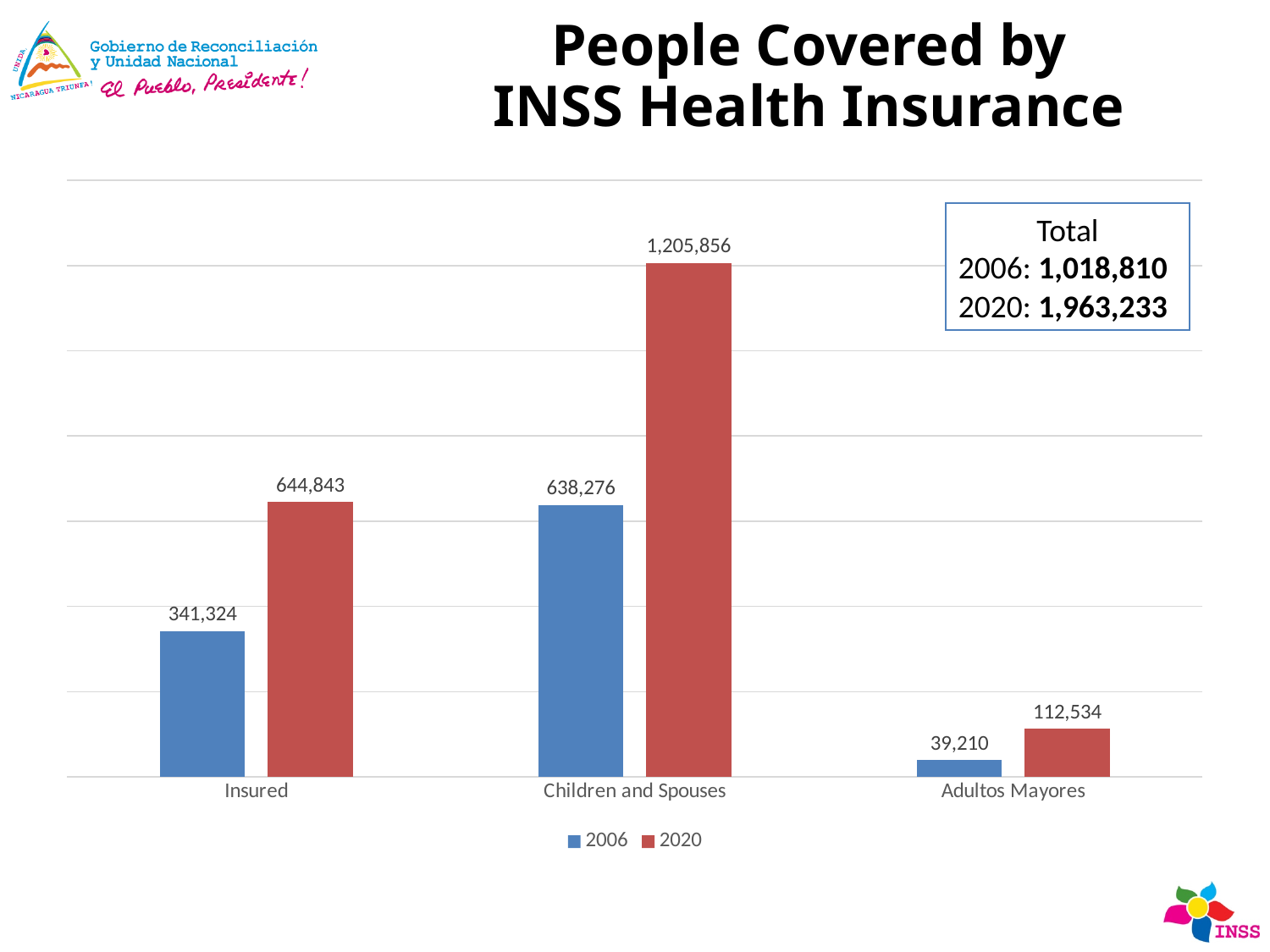
What is the 2020 value for Children and Spouses? 1,205,856 What is the 2006 value for Insured? 341,324 How many series does the legend list? 2 What kind of chart is shown on the slide? bar chart What is the difference between the 2020 and 2006 values for Adultos Mayores? 73,324 How many categories are shown on the x axis? 3 What is the difference between the 2020 and 2006 values for Insured? 303,519 Which is larger: the 2006 value for Children and Spouses or the 2020 value for Insured? 2020 value for Insured Which category has the highest 2020 value? Children and Spouses What is the 2020 value for Adultos Mayores? 112,534 What is the 2006 value for Children and Spouses? 638,276 Which category has the lowest 2006 value? Adultos Mayores